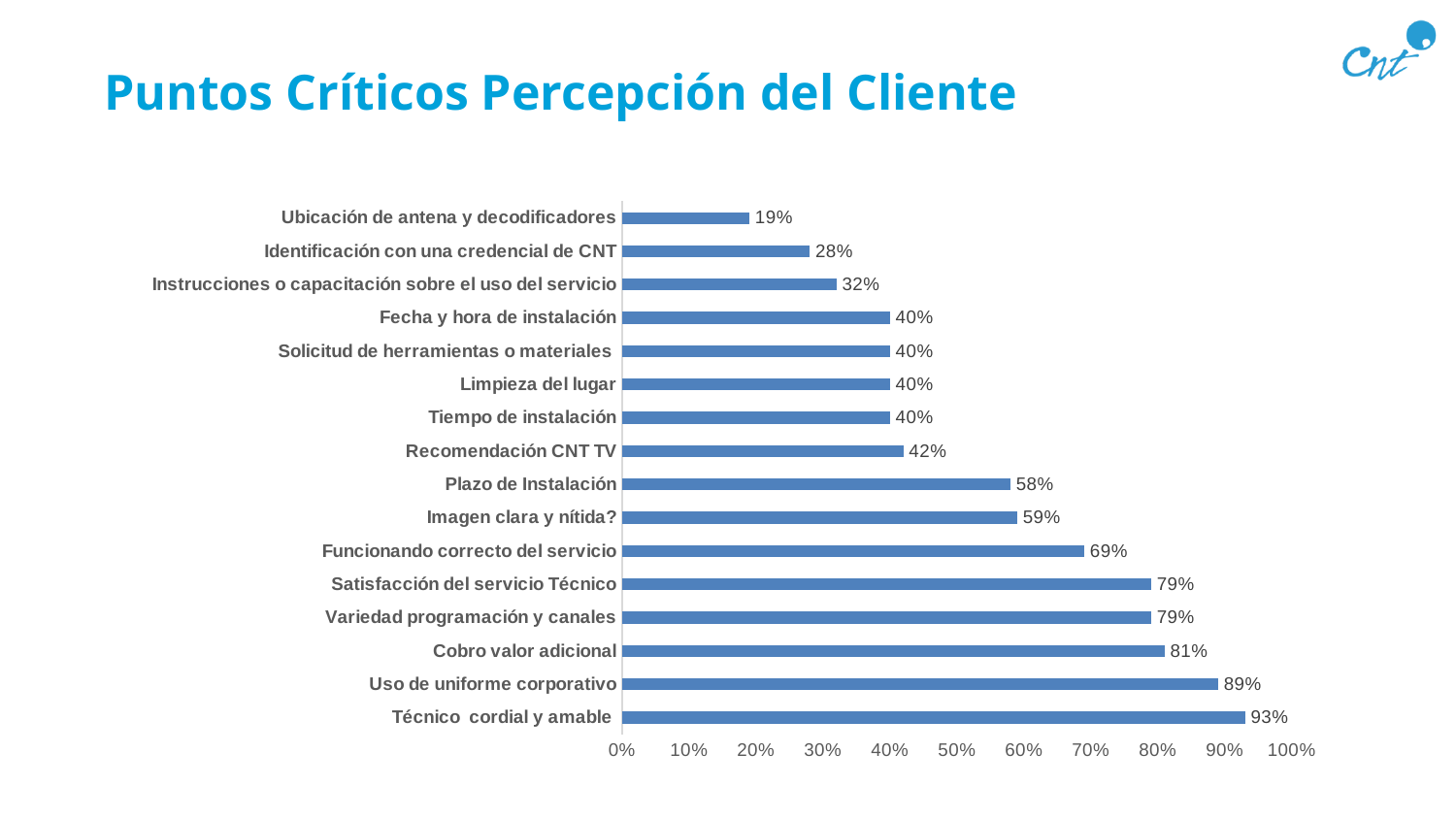
What is the difference between the values for Uso de uniforme corporativo and Cobro valor adicional? 8% What is the difference between the values for Plazo de Instalación and Identificación con una credencial de CNT? 30% What is the value for Funcionando correcto del servicio? 69% What is the value for Ubicación de antena y decodificadores? 19% What is the value for Técnico cordial y amable? 93% What is the title of the slide containing the chart? Puntos Críticos Percepción del Cliente Which category has the highest value? Técnico cordial y amable What is the value for Recomendación CNT TV? 42% How many categories are shown in the chart? 16 What kind of chart is shown on the slide? Bar chart Which category has the lowest value? Ubicación de antena y decodificadores Which is larger, the value for Imagen clara y nítida? or the value for Instrucciones o capacitación sobre el uso del servicio? Imagen clara y nítida?